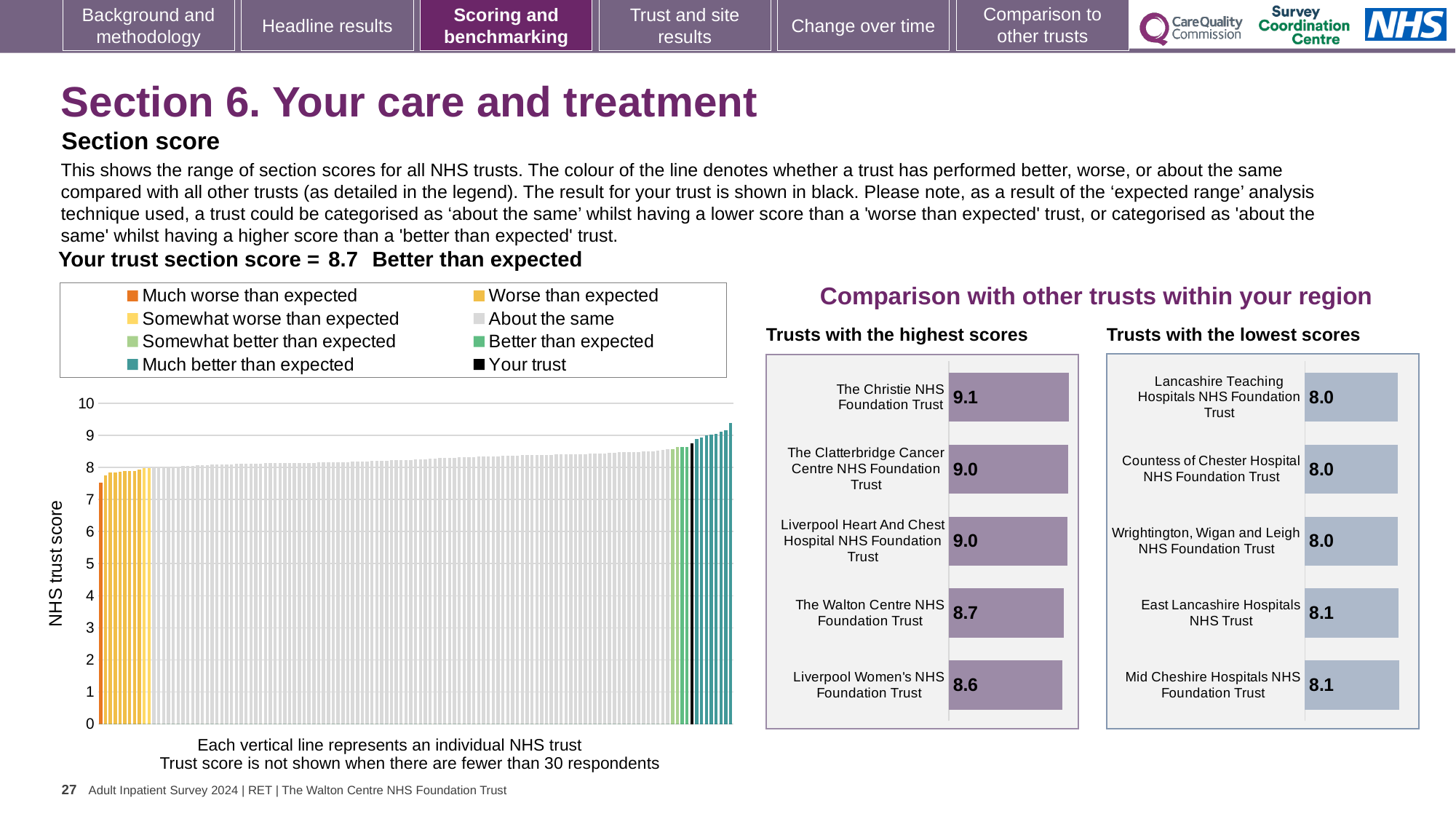
In the large 'NHS trust score' chart on the left, how many entries does the legend list? 8 In the 'Trusts with the highest scores' chart, what is the difference between the scores of The Christie NHS Foundation Trust and Liverpool Women's NHS Foundation Trust? 0.5 In the 'Trusts with the highest scores' chart, what is the score for Liverpool Women's NHS Foundation Trust? 8.6 In the 'Trusts with the lowest scores' chart, what is the score for Wrightington, Wigan and Leigh NHS Foundation Trust? 8.0 In the large 'NHS trust score' chart on the left, is the value of the leftmost (orange) bar greater or less than 8? less In the 'Trusts with the highest scores' chart, what is the score for The Christie NHS Foundation Trust? 9.1 In the 'Trusts with the highest scores' chart, which trust has the highest score? The Christie NHS Foundation Trust In the 'Trusts with the highest scores' chart, which is larger: the score for The Christie NHS Foundation Trust or The Walton Centre NHS Foundation Trust? The Christie NHS Foundation Trust In the 'Trusts with the highest scores' chart, how many trusts are shown? 5 In the large 'NHS trust score' chart on the left, what kind of chart is it? Bar chart In the large 'NHS trust score' chart on the left, do the trust scores rise or fall from left to right? Rise In the 'Trusts with the lowest scores' chart, what is the score for East Lancashire Hospitals NHS Trust? 8.1